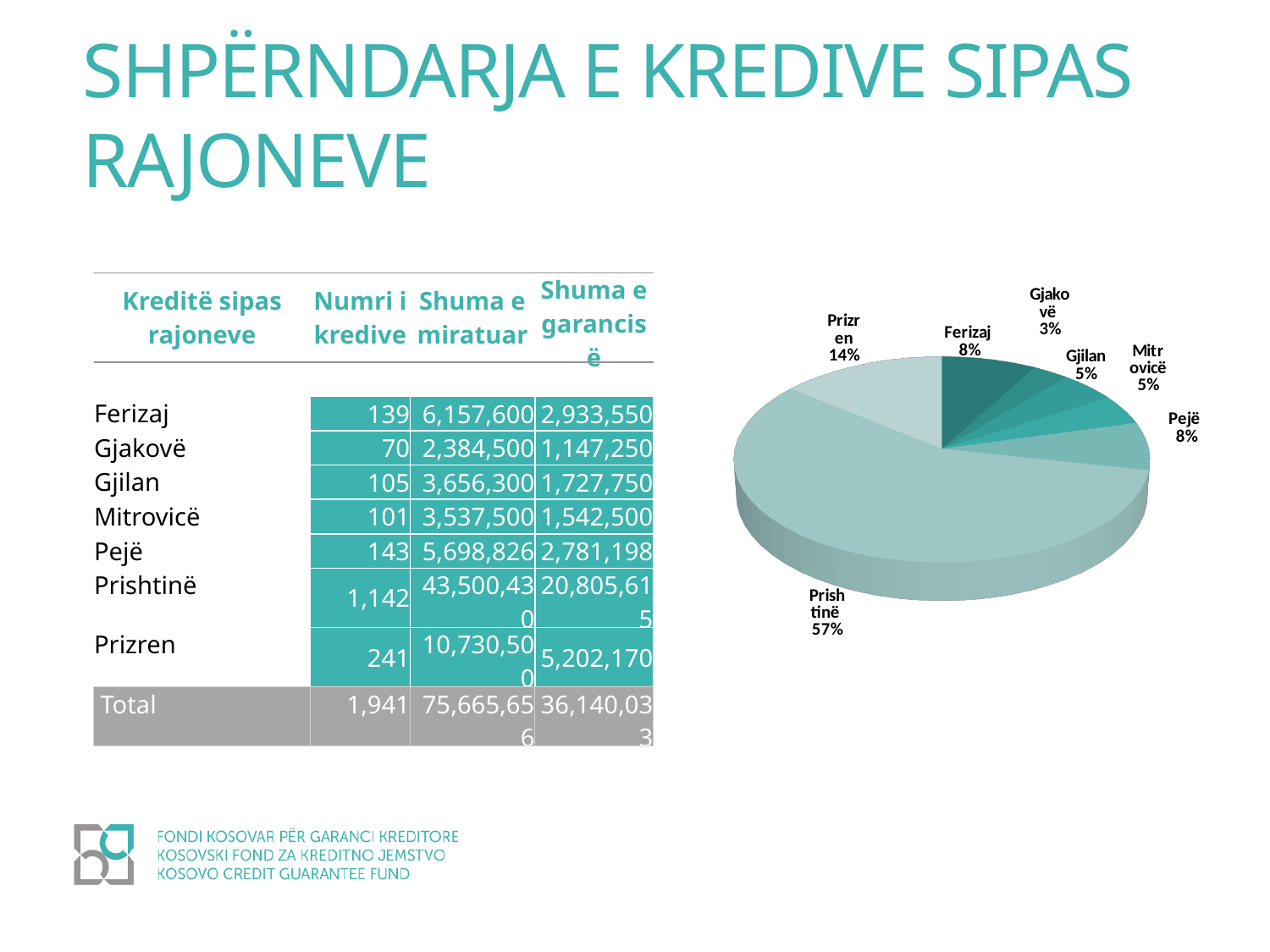
Which slice is larger in the pie chart, Prizren or Pejë? Prizren What share of the pie does Mitrovicë hold? 5% What share of the pie does Prizren hold? 14% What share of the pie does Ferizaj hold? 8% How many slices does the pie chart have? 7 Which region has the largest slice of the pie chart? Prishtinë Which region has the smallest slice of the pie chart? Gjakovë Which two regions share the same percentage of 5% in the pie chart? Gjilan and Mitrovicë What kind of chart is shown on the slide? pie chart What is the difference in percentage points between the Prishtinë slice and the Prizren slice? 43